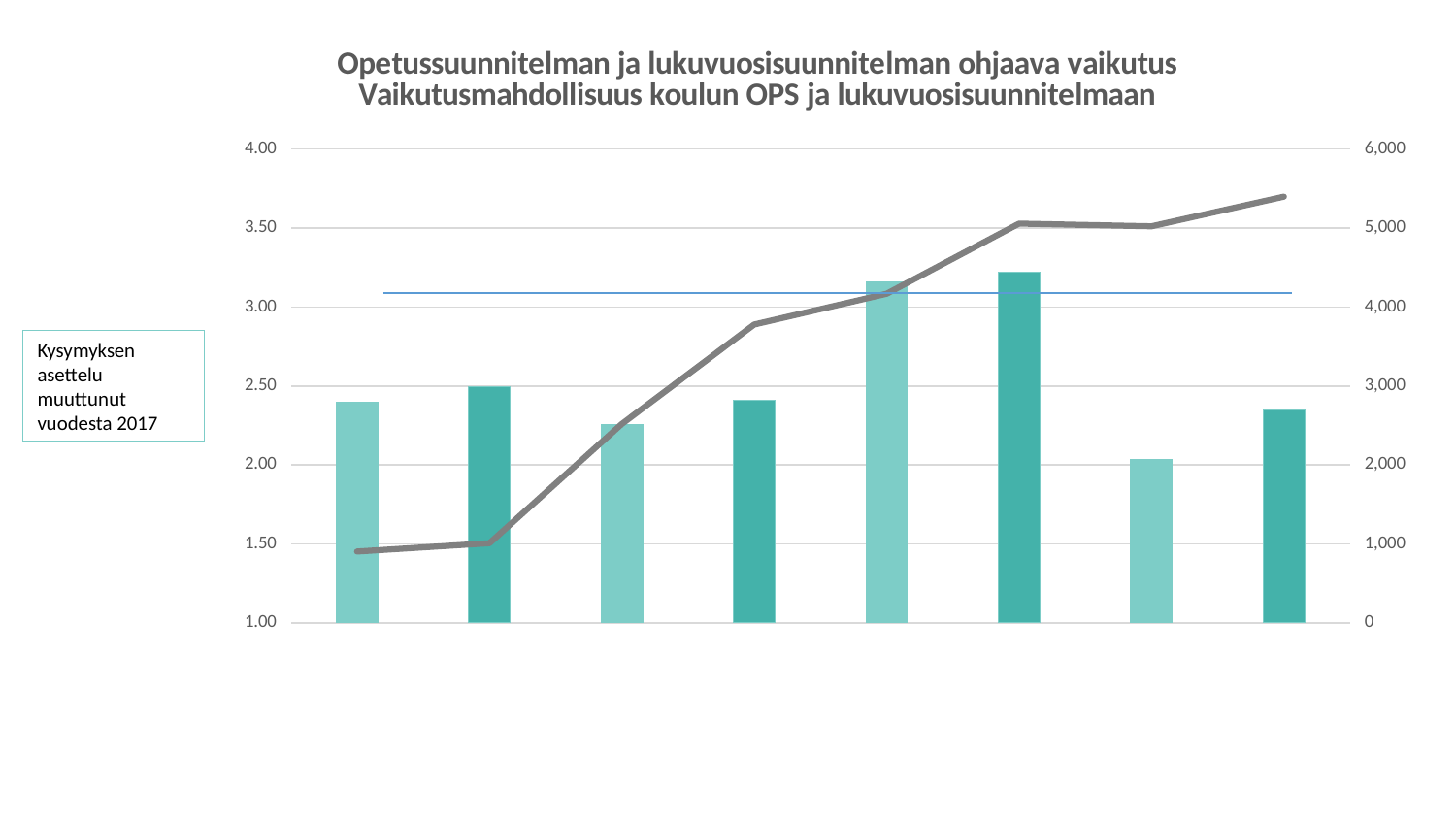
Which bar is the tallest in the chart? The sixth bar Which is taller, the fifth bar or the seventh bar? The fifth bar Is the value of the seventh bar greater or less than 2.50 on the left axis? less Is the value of the fifth bar greater or less than 3.00 on the left axis? greater Is the last point of the grey line greater or less than 5,000 on the right axis? greater Which bar is the shortest in the chart? The seventh bar How many points does the grey line have? 8 Does the grey line generally rise or fall from left to right? Rise What kind of chart is shown on the slide? A combined bar and line chart What is the first line of the chart title? Opetussuunnitelman ja lukuvuosisuunnitelman ohjaava vaikutus How many bars are plotted in the chart? 8